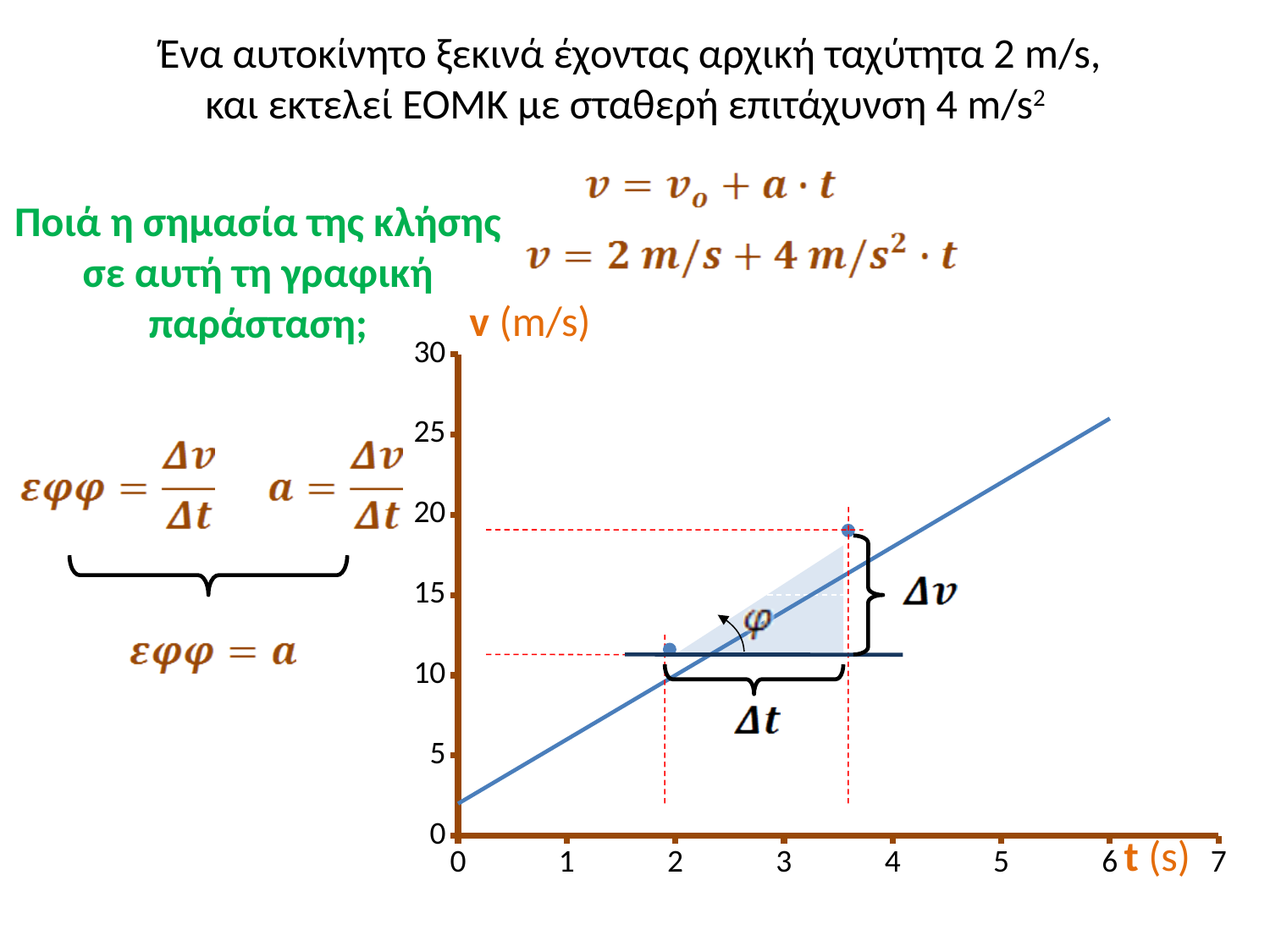
Is the value of v on the line at t = 0 s greater or less than 5? less What kind of chart is shown on the slide? line chart What is the label of the horizontal axis of the chart? t (s) Does the plotted line rise or fall as t increases? rises What is the value of v on the line at t = 2 s? 10 How many lines are plotted on the chart? 1 Is the value of v on the line at t = 1 s greater or less than 5? greater Is the value of v on the line at t = 5 s greater or less than 20? greater What is the highest tick value shown on the vertical axis? 30 What is the label of the vertical axis of the chart? v (m/s)